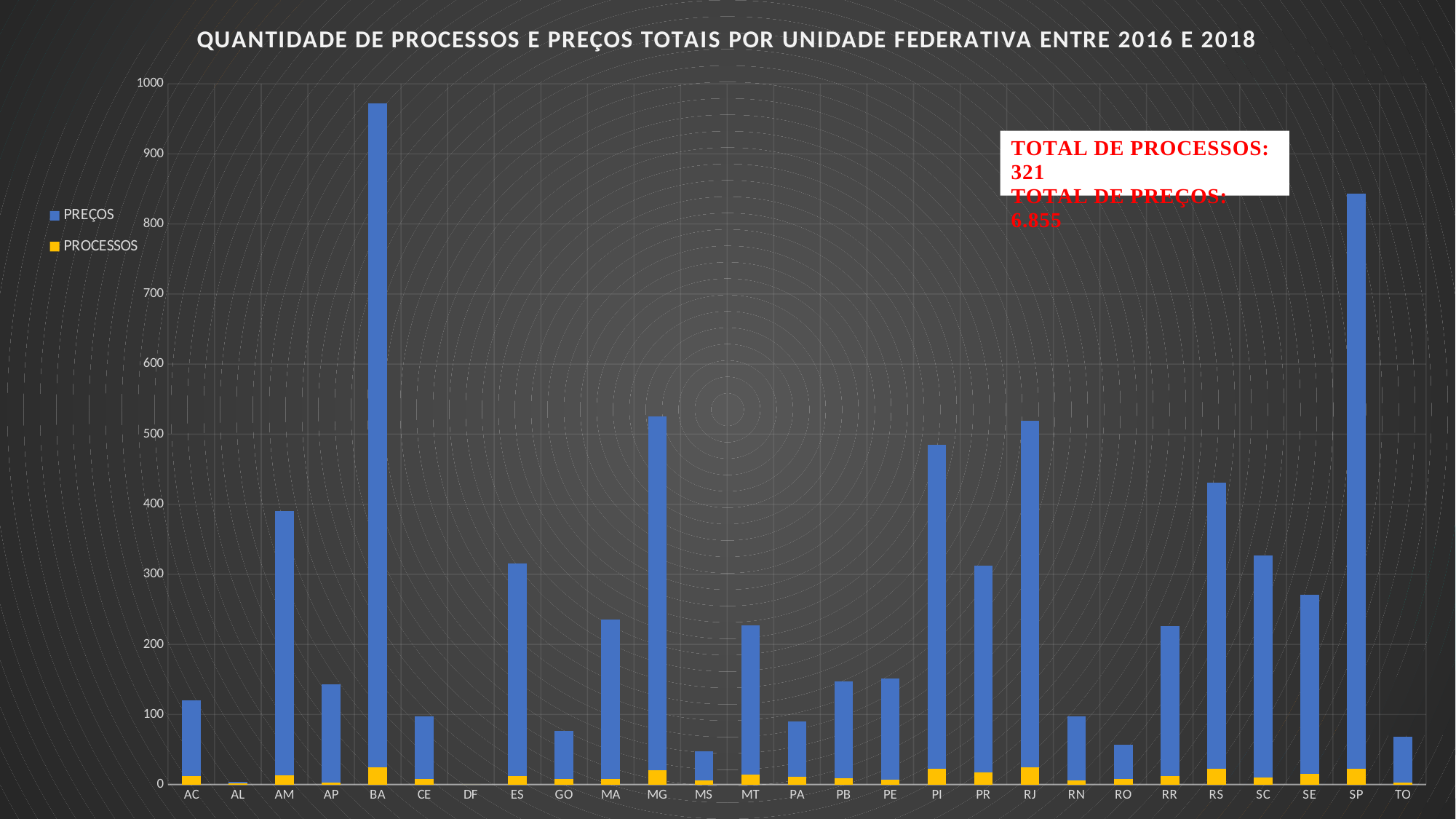
Which has the taller bar, BA or SP? BA Is the total bar for SP greater or less than 800? greater Which series is shown in yellow in the legend? PROCESSOS What kind of chart is shown on the slide? Stacked bar chart Is the total bar for BA greater or less than 900? greater How many series does the legend list? 2 According to the text box on the slide, what is the total number of processos? 321 Which has the taller bar, RS or SC? RS Which federative unit has the tallest bar? BA How many federative units (categories) are shown on the x axis? 27 Is the total bar for RS greater or less than 400? greater